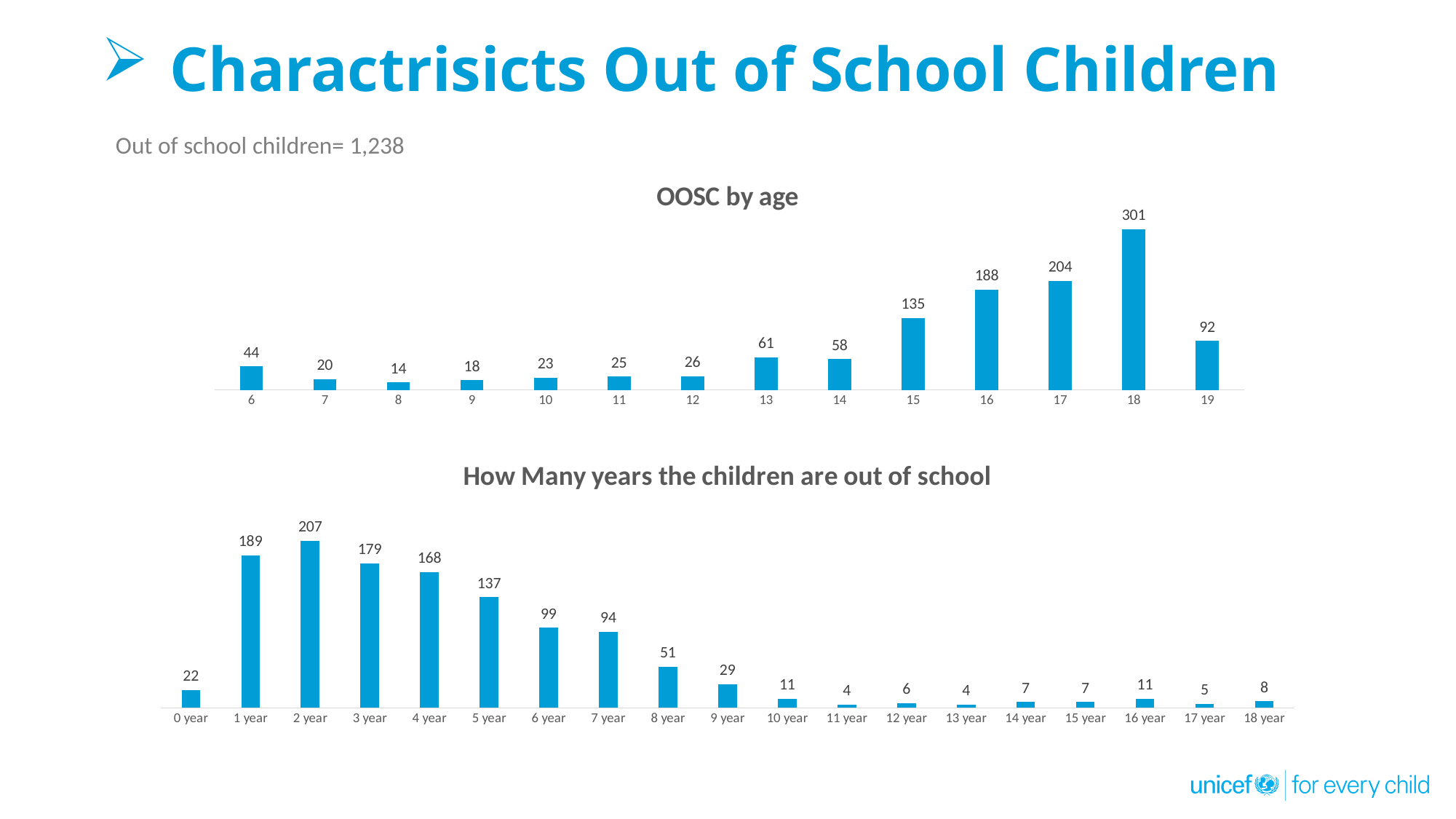
In the 'OOSC by age' chart, how many age categories are shown on the x axis? 14 In the 'How Many years the children are out of school' chart, do the values generally rise or fall from 2 year to 9 year? fall In the 'OOSC by age' chart, what is the value for age 18? 301 In the 'How Many years the children are out of school' chart, what is the value for 2 year? 207 In the 'OOSC by age' chart, what is the difference between the values for age 17 and age 16? 16 In the 'How Many years the children are out of school' chart, what is the difference between the values for 1 year and 0 year? 167 In the 'How Many years the children are out of school' chart, which category has the highest value? 2 year What kind of chart is the 'OOSC by age' chart? bar chart In the 'OOSC by age' chart, which is larger, the value for age 15 or the value for age 19? age 15 In the 'How Many years the children are out of school' chart, how many categories are shown on the x axis? 19 In the 'OOSC by age' chart, which age has the lowest value? 8 What is the title of the bottom chart on the slide? How Many years the children are out of school